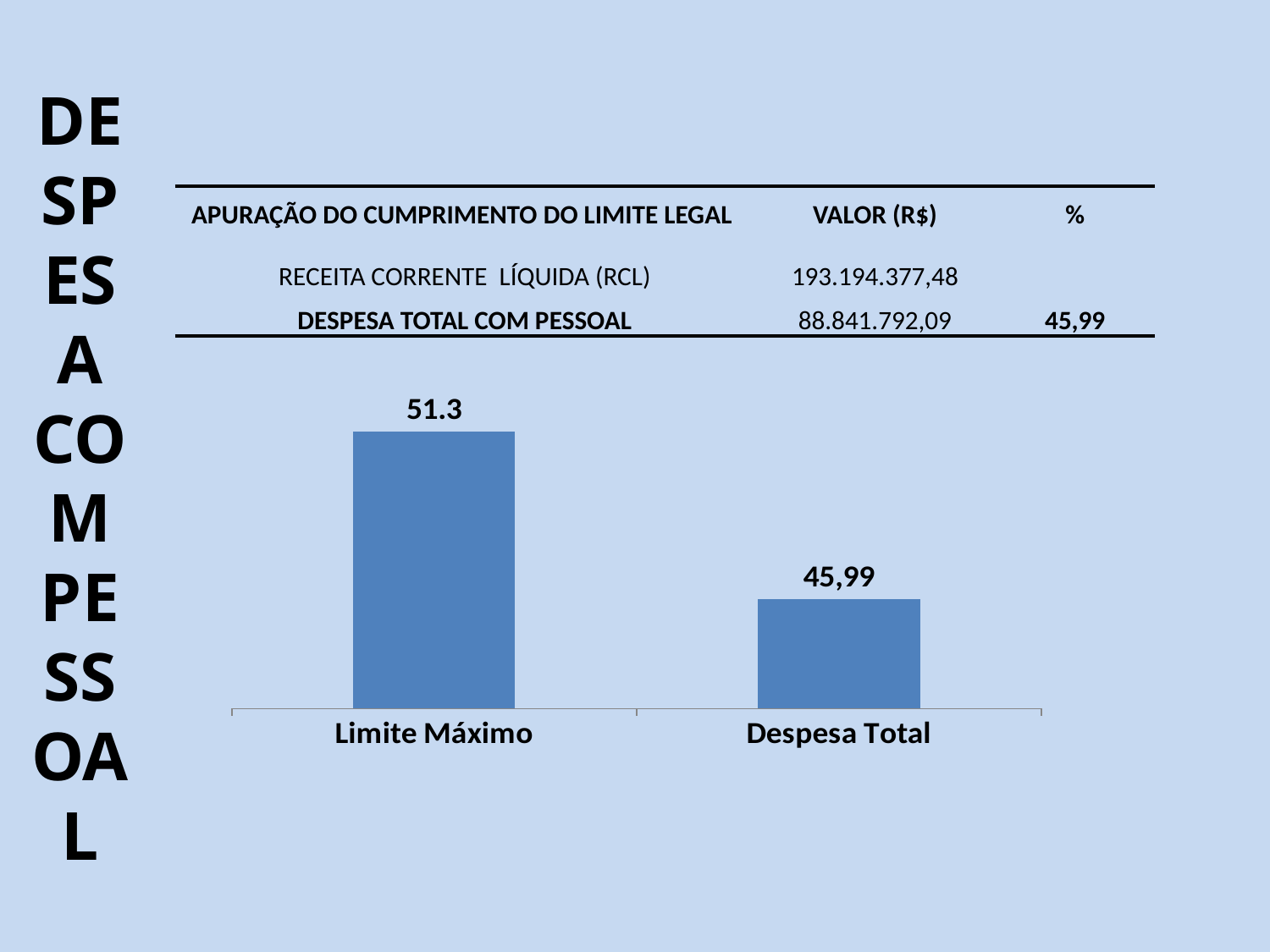
How many bars are plotted in the chart? 2 Which category has the highest bar in the chart? Limite Máximo What is the value of the Despesa Total bar in the bar chart? 45,99 What colour are the bars in the chart? blue What kind of chart is shown on the slide? bar chart What are the two category labels on the x axis of the chart? Limite Máximo and Despesa Total What is the value of the Limite Máximo bar in the bar chart? 51.3 Do the bar values rise or fall from left to right across the chart? fall Is the bar for Limite Máximo larger or smaller than the bar for Despesa Total? larger Which category has the lowest bar in the chart? Despesa Total What is the difference between the Limite Máximo value and the Despesa Total value in the chart? 5.31